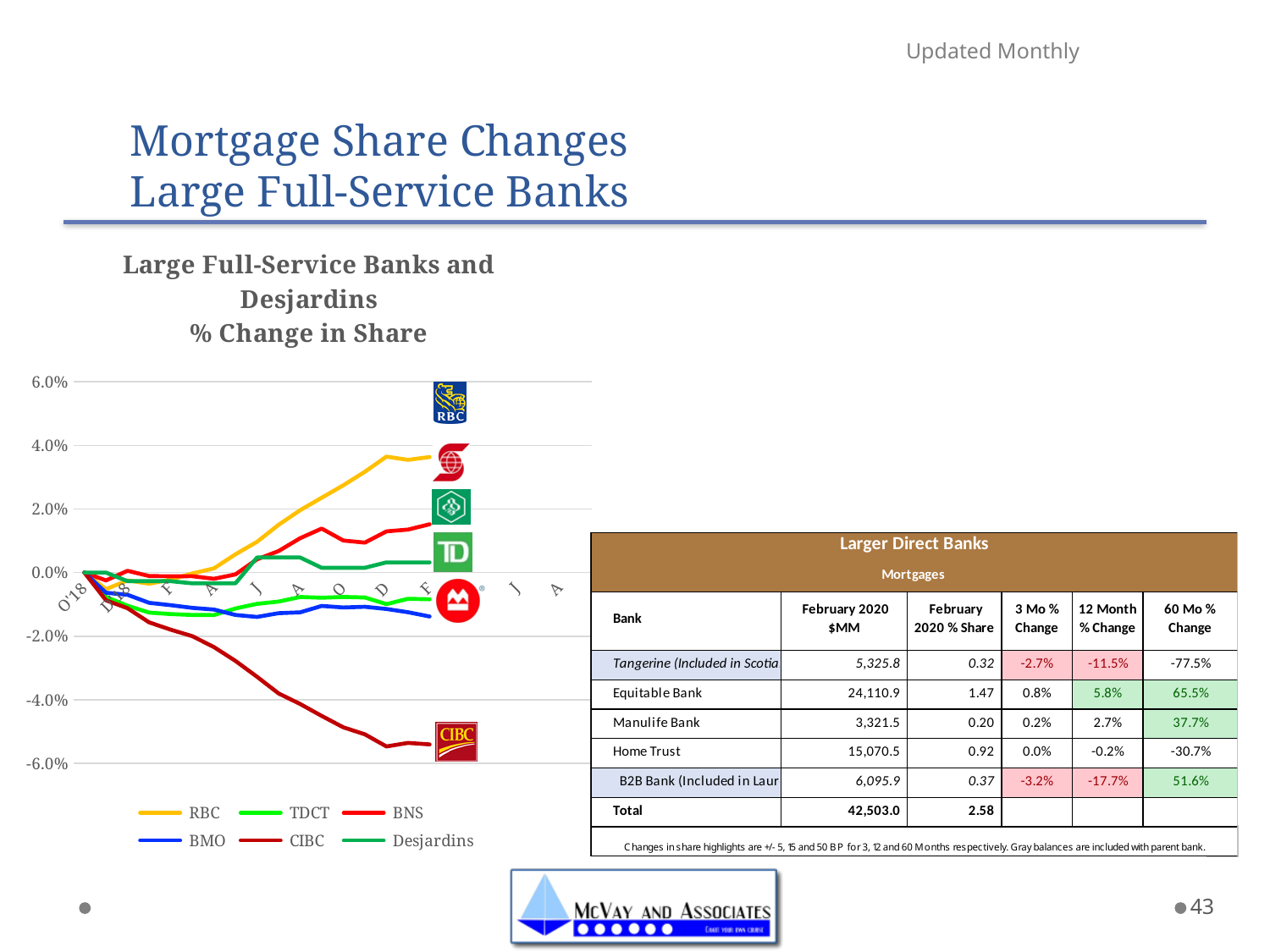
Is the final value for CIBC greater or less than -4.0%? less Is the final value for BNS greater or less than 0.0%? greater Which bank has the highest % change in share at the right end of the chart? RBC What kind of chart is shown on the slide? line chart Is the final value for RBC greater or less than 2.0%? greater What is the title of the chart? Large Full-Service Banks and Desjardins % Change in Share Does the RBC line rise or fall over the period shown? rise At the right end of the chart, which is larger: the value for BNS or the value for TDCT? BNS How many series does the chart legend list? 6 Which bank has the lowest % change in share at the right end of the chart? CIBC Does the CIBC line rise or fall over the period shown? fall